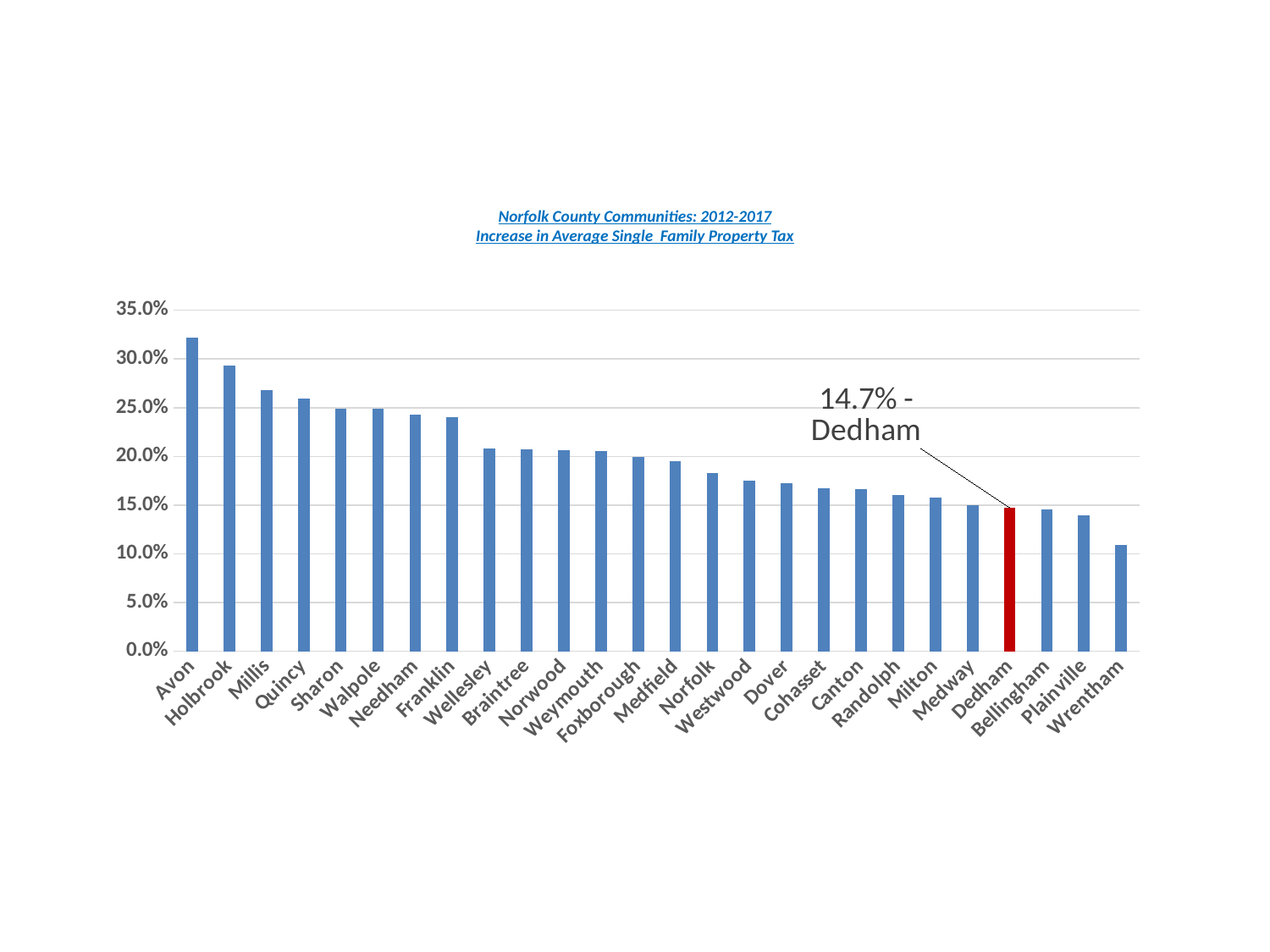
Is the value for Millis greater or less than 25.0%? greater Which community has the highest increase in average single family property tax? Avon Which has the larger value, Holbrook or Milton? Holbrook Which community's bar is highlighted in red? Dedham What kind of chart is shown on the slide? bar chart How many communities are shown on the chart? 26 Is the value for Avon greater or less than 30.0%? greater What is the value for Dedham? 14.7% Which community has the lowest increase in average single family property tax? Wrentham Is the value for Wrentham greater or less than 15.0%? less Do the values rise or fall moving from left to right along the x axis? fall